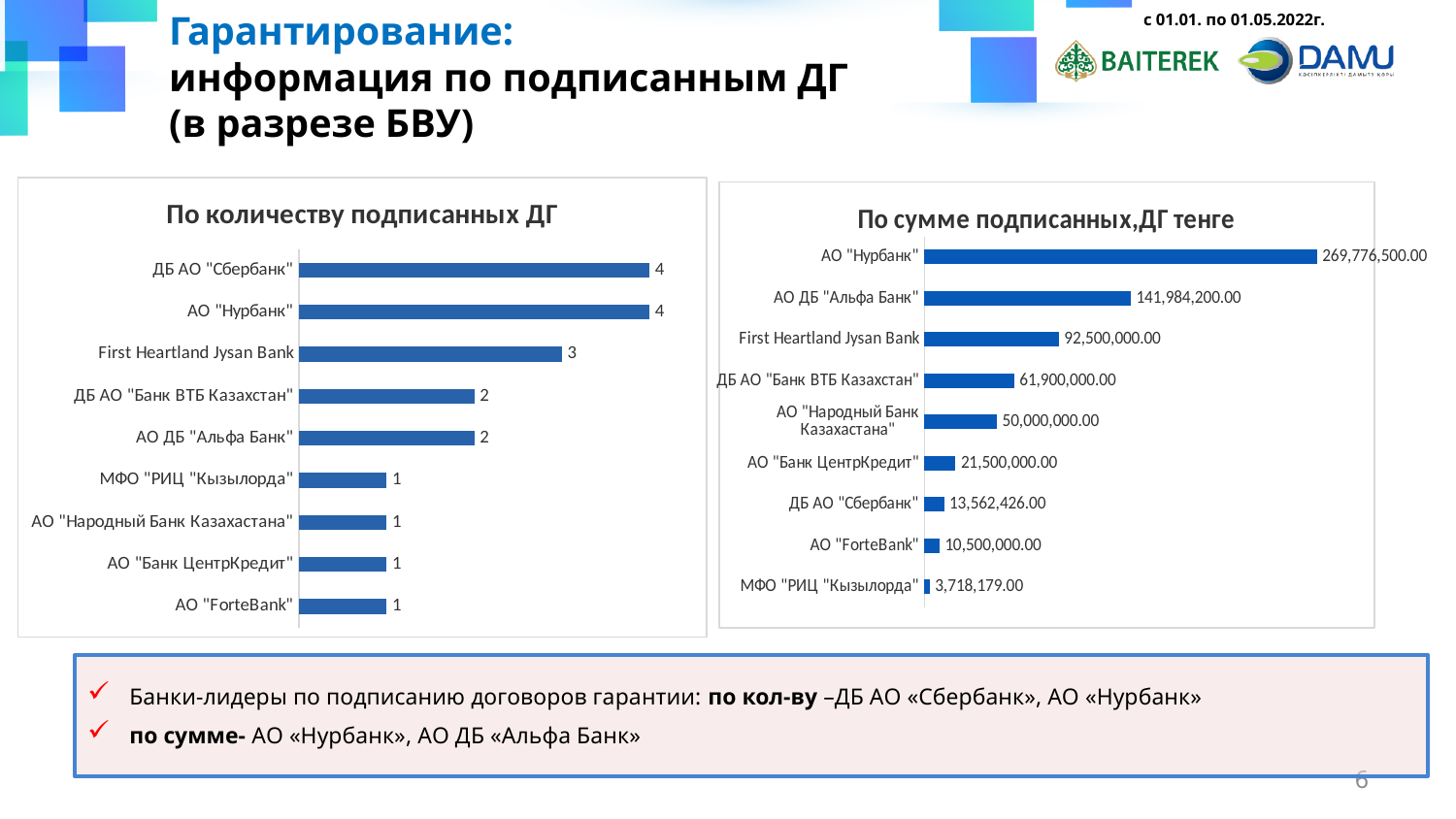
In the chart "По количеству подписанных ДГ", what is the value for First Heartland Jysan Bank? 3 In the chart "По сумме подписанных,ДГ тенге", what is the value for ДБ АО "Сбербанк"? 13,562,426.00 In the chart "По количеству подписанных ДГ", which has the larger value: First Heartland Jysan Bank or АО ДБ "Альфа Банк"? First Heartland Jysan Bank In the chart "По сумме подписанных,ДГ тенге", what is the value for АО "Нурбанк"? 269,776,500.00 In the chart "По сумме подписанных,ДГ тенге", what is the difference between the values for АО "Нурбанк" and АО ДБ "Альфа Банк"? 127,792,300.00 In the chart "По количеству подписанных ДГ", what is the difference between the values for ДБ АО "Сбербанк" and АО "ForteBank"? 3 In the chart "По сумме подписанных,ДГ тенге", which category has the lowest value? МФО "РИЦ "Кызылорда" In the chart "По количеству подписанных ДГ", how many categories are shown? 9 In the chart "По сумме подписанных,ДГ тенге", which has the larger value: First Heartland Jysan Bank or ДБ АО "Банк ВТБ Казахстан"? First Heartland Jysan Bank In the chart "По количеству подписанных ДГ", what is the value for ДБ АО "Банк ВТБ Казахстан"? 2 In the chart "По сумме подписанных,ДГ тенге", which category has the highest value? АО "Нурбанк" What type of chart is the chart "По сумме подписанных,ДГ тенге"? Bar chart